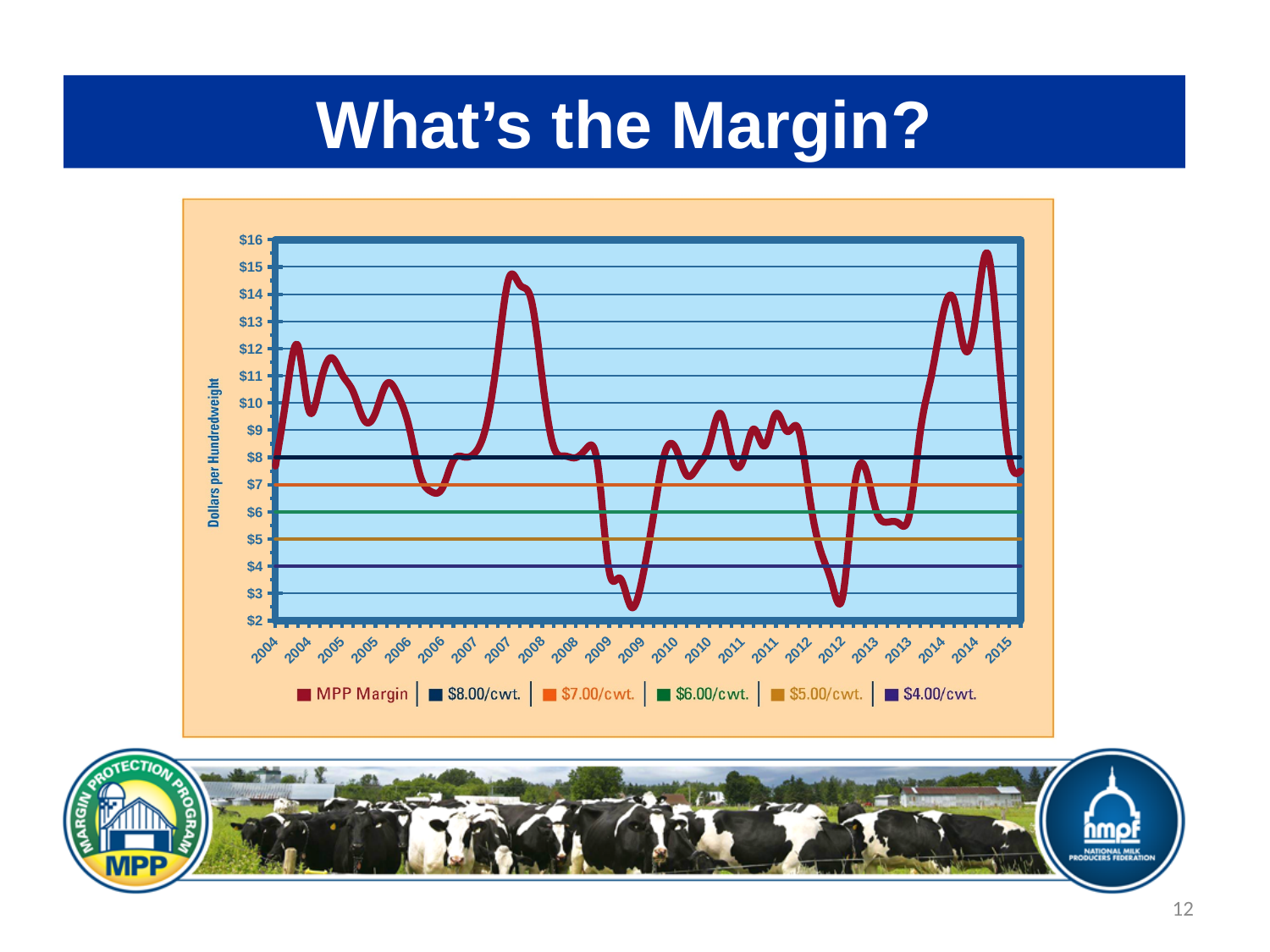
Is the lowest MPP Margin value in 2012 greater or less than $4? less Is the MPP Margin value at the start of 2004 greater or less than $6? greater How many horizontal reference lines (other than the MPP Margin) are plotted on the chart? 5 Is the lowest MPP Margin value in 2009 greater or less than $4? less Which legend entry corresponds to the red line on the chart? MPP Margin What kind of chart is shown on the slide? line chart Does the MPP Margin rise or fall from 2013 to its 2014 peak? rise In which year does the MPP Margin reach its highest point? 2014 What is the label on the vertical axis of the chart? Dollars per Hundredweight How many series does the legend list? 6